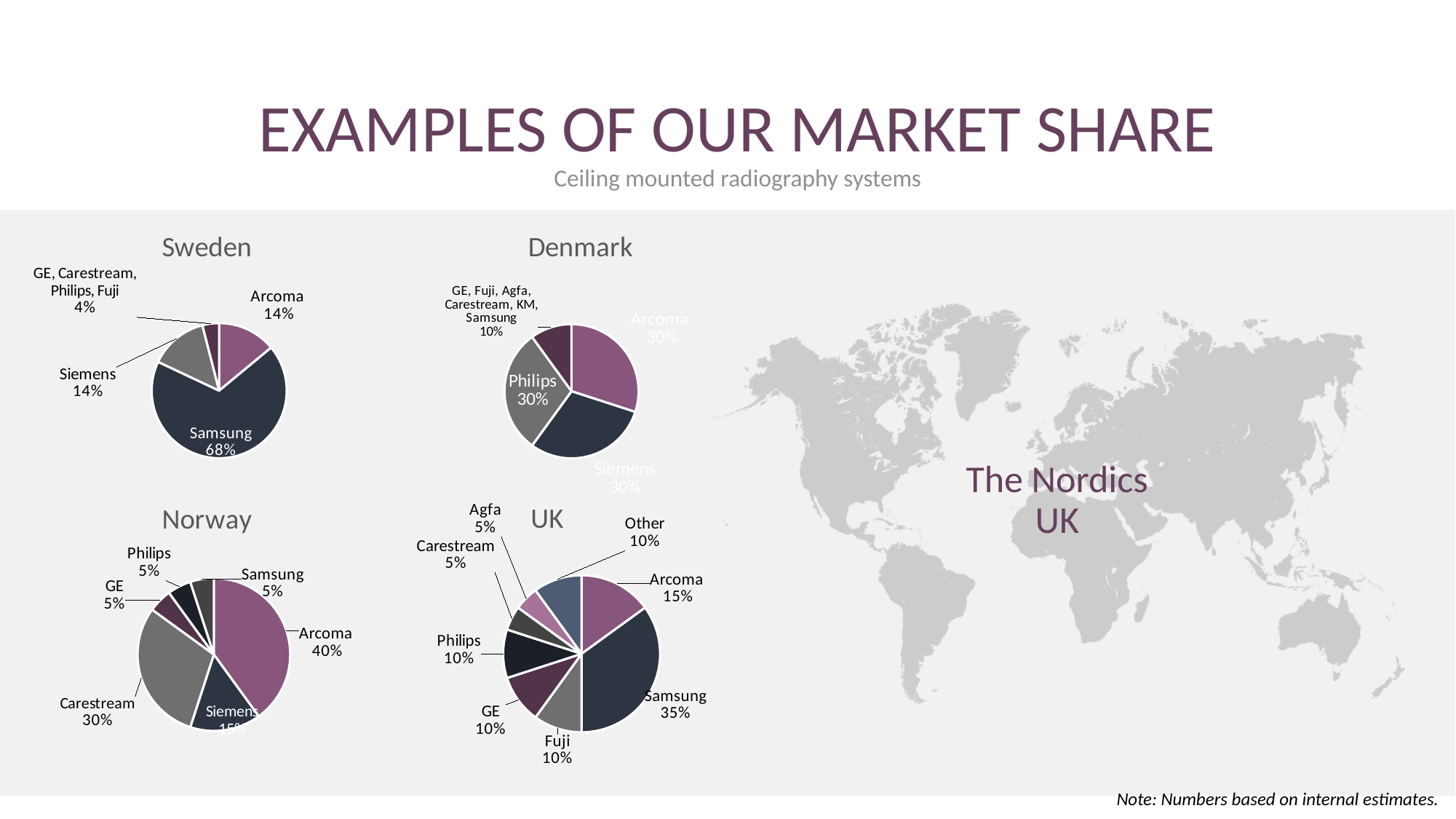
In the Denmark pie chart, what is Philips' market share? 30% In the Norway pie chart, which company has the largest share? Arcoma In the Norway pie chart, what is Arcoma's market share? 40% In the Sweden pie chart, what is the difference between Samsung's share and Arcoma's share? 54% In the UK pie chart, what is Samsung's market share? 35% In the Norway pie chart, which is larger, Carestream's share or Arcoma's share? Arcoma In the Sweden pie chart, what is Samsung's market share? 68% In the Denmark pie chart, what is the combined share of GE, Fuji, Agfa, Carestream, KM and Samsung? 10% In the UK pie chart, what is the difference between Samsung's share and Arcoma's share? 20% In the Sweden pie chart, which company has the largest share? Samsung How many slices does the UK pie chart have? 8 What type of chart is used for the Sweden market share? Pie chart